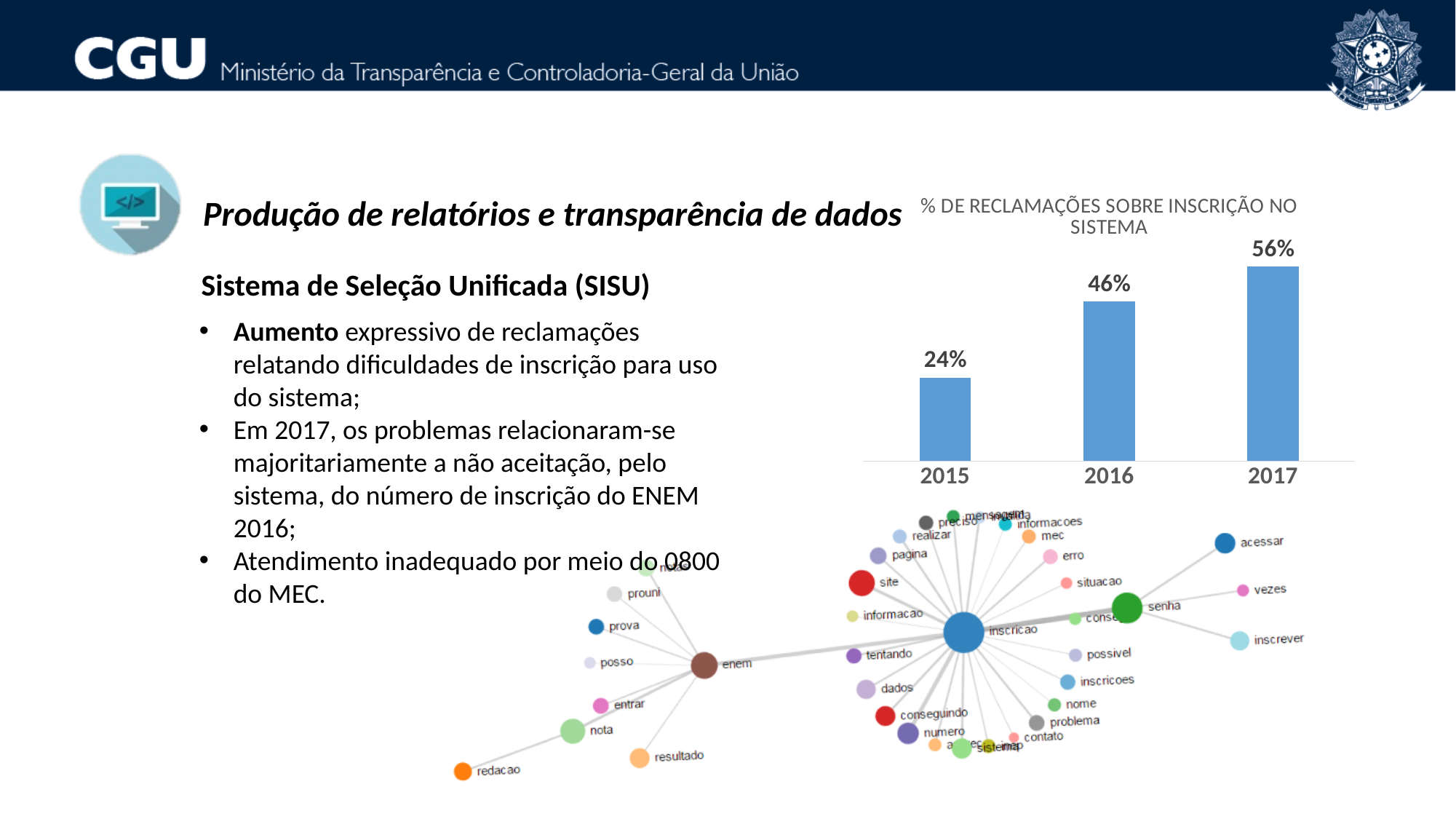
Which year has the highest value in the chart '% DE RECLAMAÇÕES SOBRE INSCRIÇÃO NO SISTEMA'? 2017 Which year has the lowest value in the chart '% DE RECLAMAÇÕES SOBRE INSCRIÇÃO NO SISTEMA'? 2015 What kind of chart is '% DE RECLAMAÇÕES SOBRE INSCRIÇÃO NO SISTEMA'? bar chart What is the value for 2015 in the chart '% DE RECLAMAÇÕES SOBRE INSCRIÇÃO NO SISTEMA'? 24% In the chart '% DE RECLAMAÇÕES SOBRE INSCRIÇÃO NO SISTEMA', which is larger, the value for 2016 or the value for 2017? 2017 What is the value for 2016 in the chart '% DE RECLAMAÇÕES SOBRE INSCRIÇÃO NO SISTEMA'? 46% In the chart '% DE RECLAMAÇÕES SOBRE INSCRIÇÃO NO SISTEMA', what is the difference between the values for 2017 and 2015? 32% How many years are shown in the chart '% DE RECLAMAÇÕES SOBRE INSCRIÇÃO NO SISTEMA'? 3 What is the value for 2017 in the chart '% DE RECLAMAÇÕES SOBRE INSCRIÇÃO NO SISTEMA'? 56% In the chart '% DE RECLAMAÇÕES SOBRE INSCRIÇÃO NO SISTEMA', what is the difference between the values for 2016 and 2015? 22% What is the title of the bar chart on the slide? % DE RECLAMAÇÕES SOBRE INSCRIÇÃO NO SISTEMA Do the values in the chart '% DE RECLAMAÇÕES SOBRE INSCRIÇÃO NO SISTEMA' rise or fall from 2015 to 2017? rise